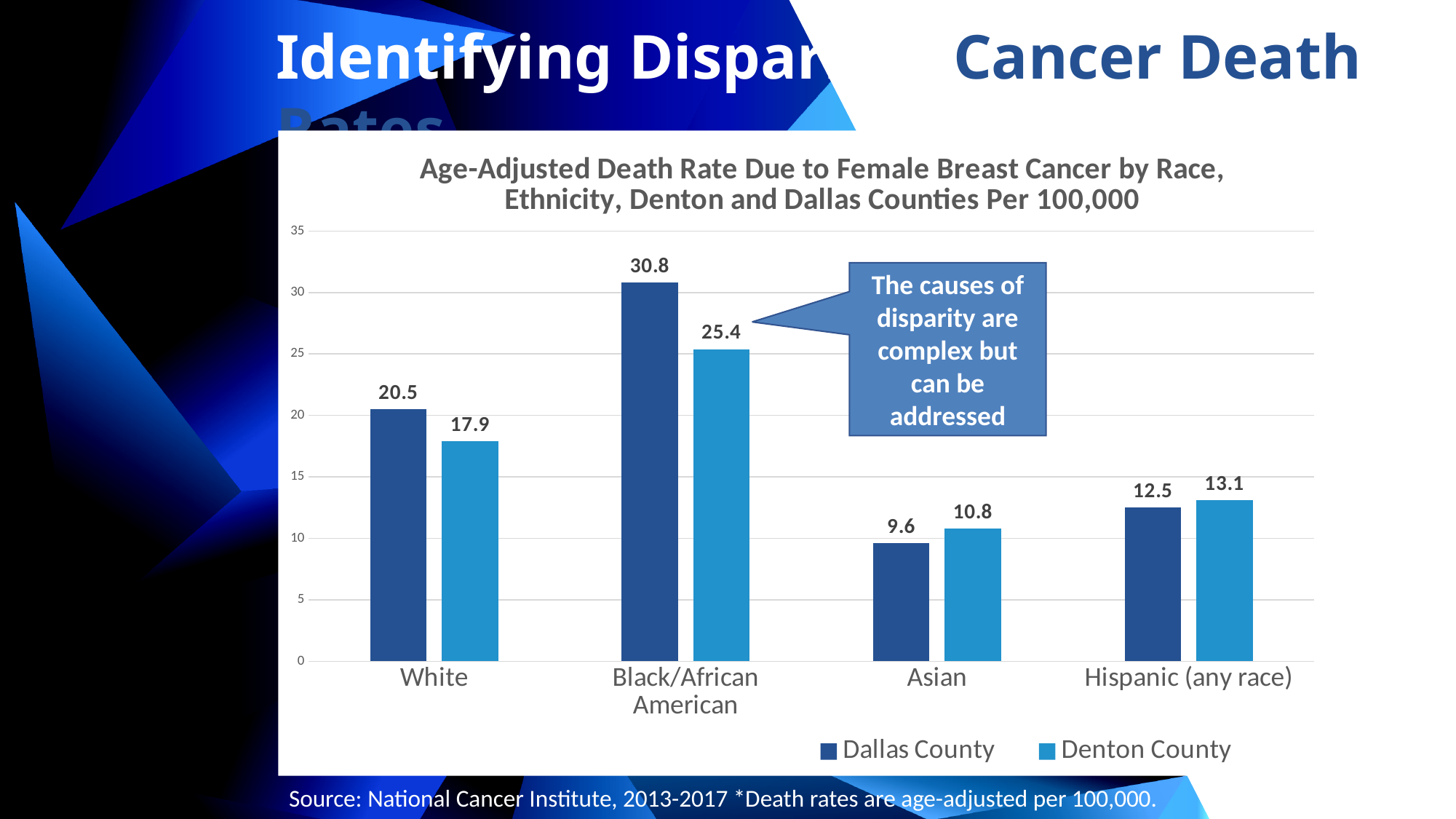
What is the Dallas County death rate for Black/African American? 30.8 How many race/ethnicity categories are shown on the x axis? 4 For Asian, which county has the higher death rate, Dallas County or Denton County? Denton County What is the Denton County death rate for White? 17.9 What does the callout box on the chart say? The causes of disparity are complex but can be addressed What kind of chart is shown on the slide? Bar chart How many series does the legend list? 2 What is the difference between the Dallas County and Denton County rates for White? 2.6 What is the Denton County value for Hispanic (any race)? 13.1 Which race/ethnicity category has the lowest Denton County death rate? Asian What is the difference between the Dallas County and Denton County rates for Black/African American? 5.4 Which race/ethnicity category has the highest Dallas County death rate? Black/African American